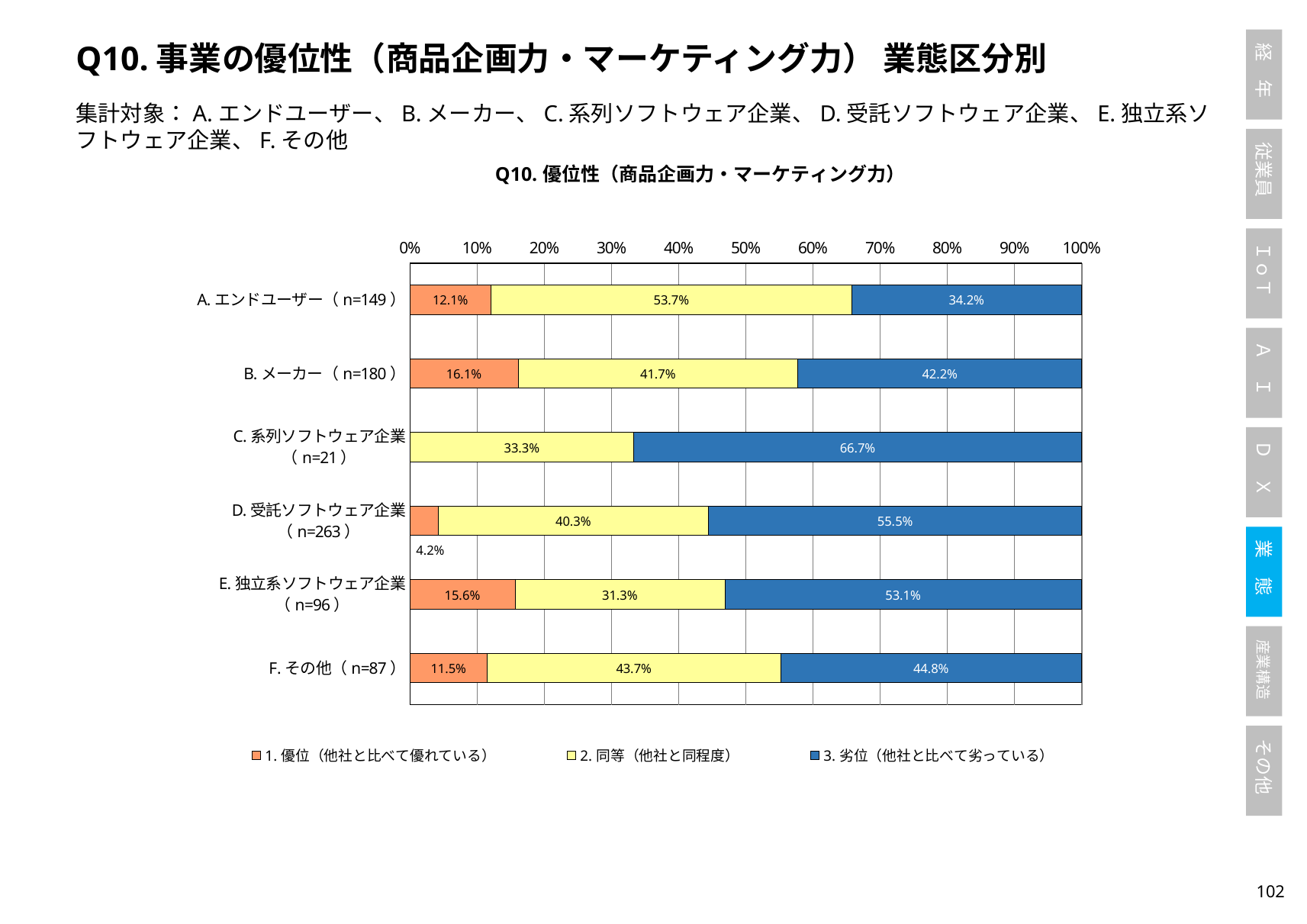
What is the value for 1. 優位（他社と比べて優れている） for B. メーカー（n=180）? 16.1% How many series does the legend list? 3 What is the total of the three segments for F. その他（n=87）? 100.0% What is the value for 2. 同等（他社と同程度） for A. エンドユーザー（n=149）? 53.7% Which is larger: the 1. 優位 value for B. メーカー or the 1. 優位 value for E. 独立系ソフトウェア企業? B. メーカー What kind of chart is shown on the slide? Stacked horizontal bar chart Which category has the highest value for 3. 劣位（他社と比べて劣っている）? C. 系列ソフトウェア企業（n=21） Which category has the lowest value for 2. 同等（他社と同程度）? E. 独立系ソフトウェア企業（n=96） Which legend entry is shown in blue? 3. 劣位（他社と比べて劣っている） What is the difference between the 2. 同等 value and the 1. 優位 value for A. エンドユーザー（n=149）? 41.6% What is the value for 3. 劣位（他社と比べて劣っている） for D. 受託ソフトウェア企業（n=263）? 55.5% How many categories (業態区分) are shown on the chart? 6